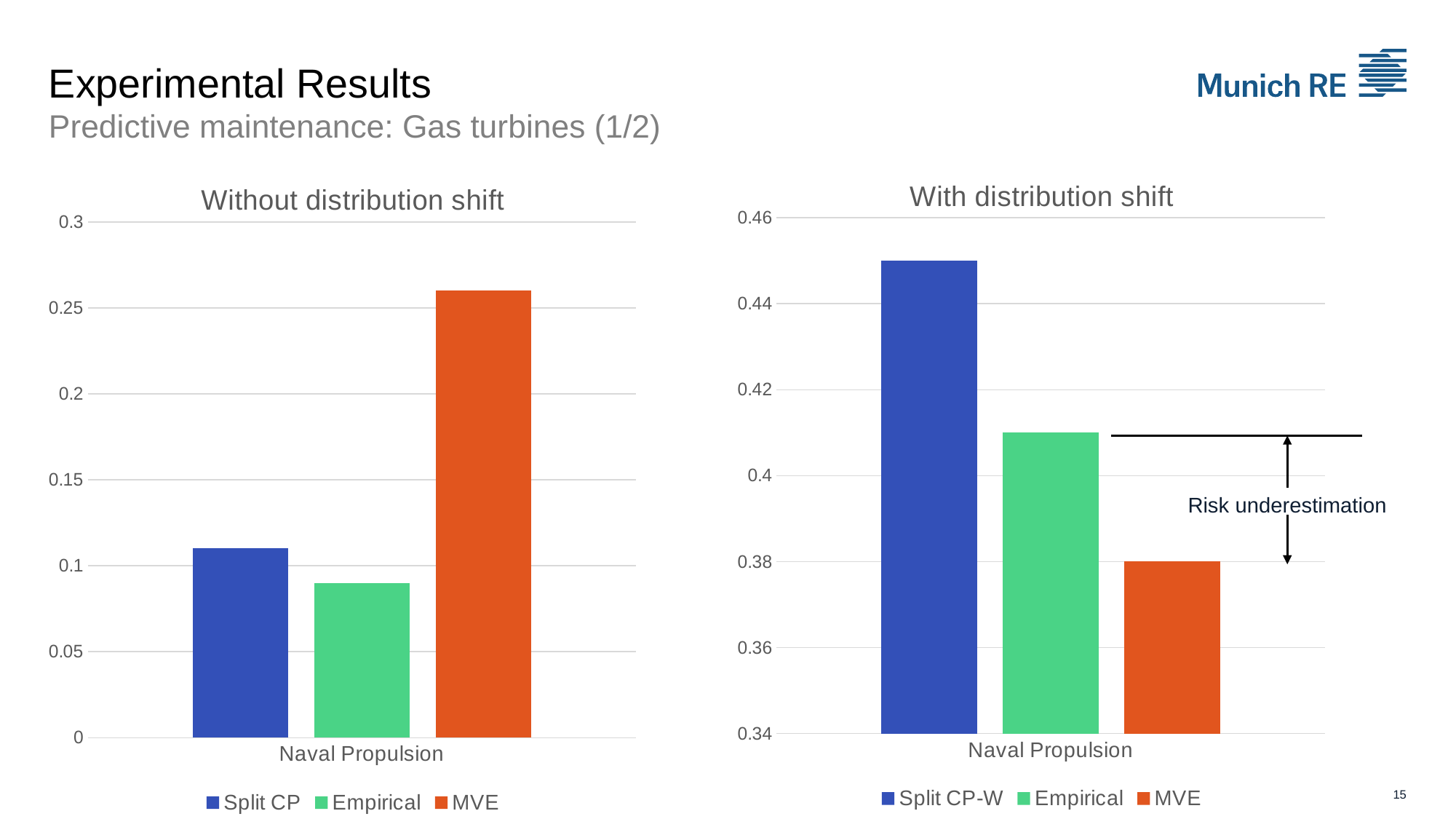
In the 'Without distribution shift' chart, which series has the highest bar? MVE In the 'With distribution shift' chart, is the value for Empirical greater or less than 0.4? greater In the 'Without distribution shift' chart, is the value for Empirical greater or less than 0.1? less What type of chart is the 'Without distribution shift' chart? Bar chart In the 'With distribution shift' chart, which series has the highest bar? Split CP-W In the 'With distribution shift' chart, which series has the lowest bar? MVE In the 'Without distribution shift' chart, which is larger, Split CP or Empirical? Split CP In the 'With distribution shift' chart, which is larger, Empirical or MVE? Empirical In the 'With distribution shift' chart, is the value for Split CP-W greater or less than 0.44? greater How many series does the legend of the 'With distribution shift' chart list? 3 In the 'Without distribution shift' chart, which series has the lowest bar? Empirical